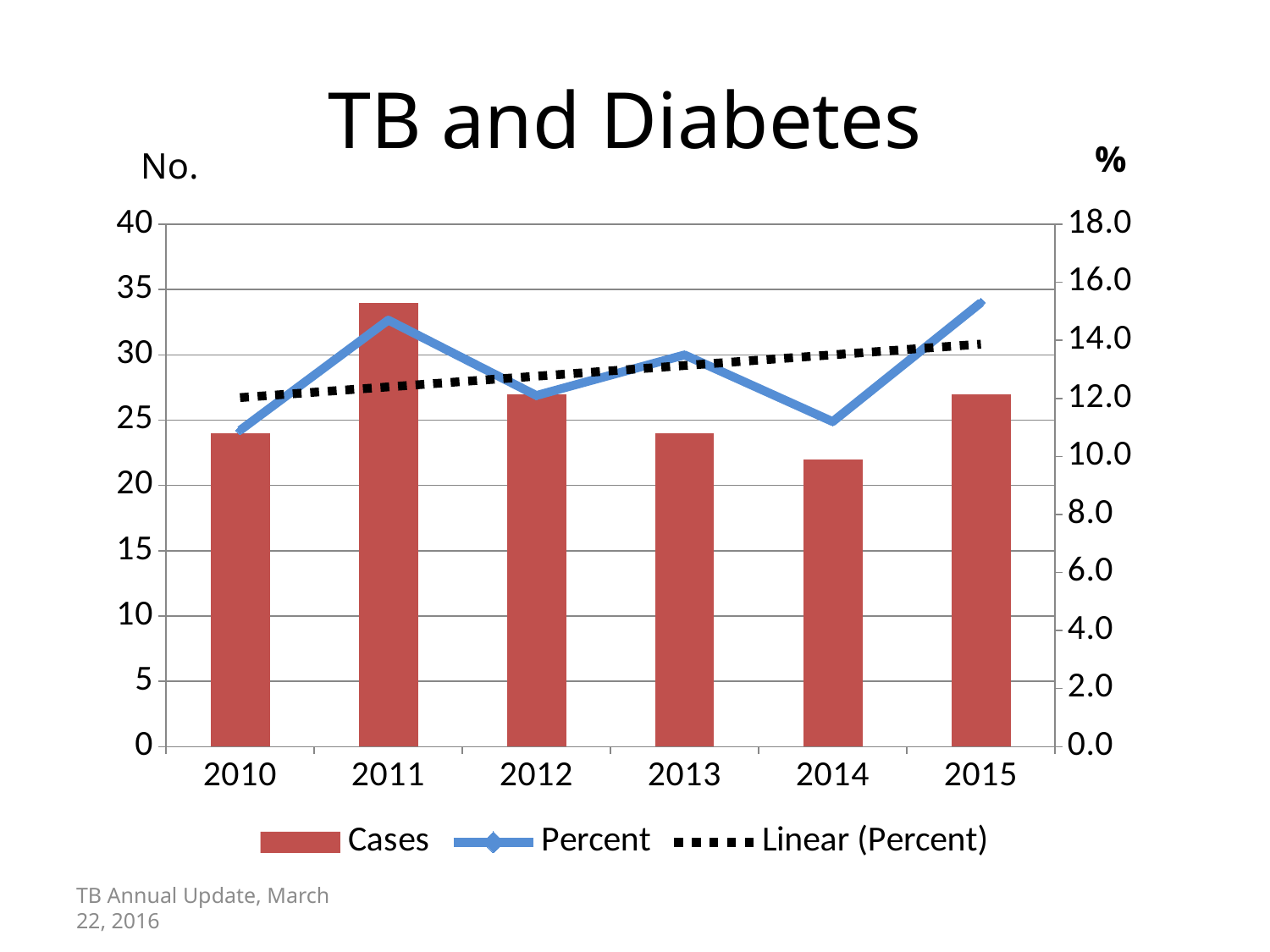
Which year has the highest number of Cases? 2011 How many years are shown on the x axis of the chart? 6 What colour are the Cases bars in the chart? Red Does the dotted Linear (Percent) trend line rise or fall from 2010 to 2015? rises What is the title of the chart? TB and Diabetes Which year has more Cases, 2011 or 2014? 2011 Is the number of Cases in 2011 greater or less than 30? greater Which year has the lowest number of Cases? 2014 How many entries does the chart legend list? 3 Is the Percent value for 2015 greater or less than 14.0? greater Is the Percent value for 2010 greater or less than 12.0? less